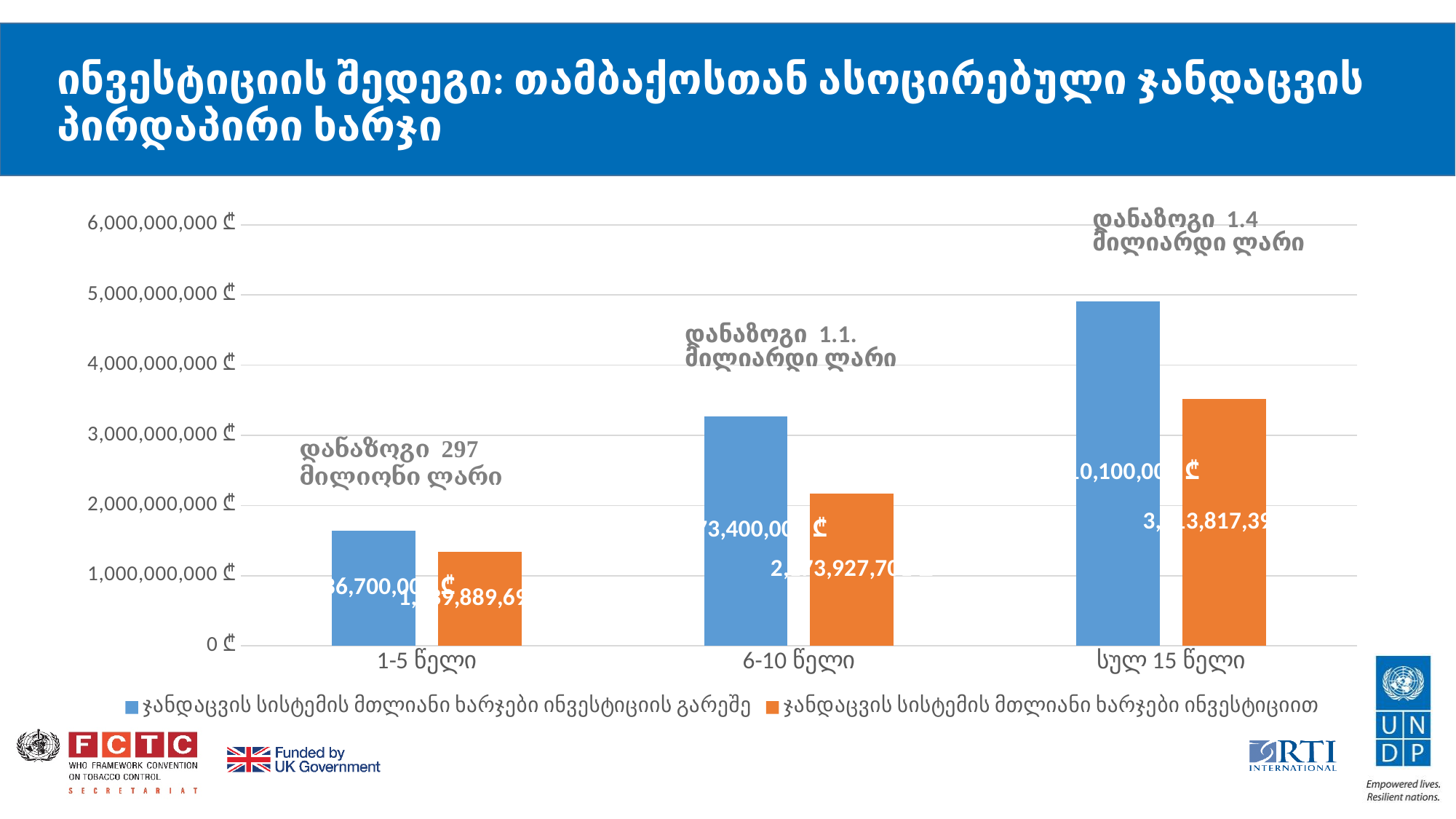
Is the value of ჯანდაცვის სისტემის მთლიანი ხარჯები ინვესტიციის გარეშე for სულ 15 წელი greater or less than 5,000,000,000 ₾? less Which category has the tallest bar in the chart? სულ 15 წელი How many series does the chart legend list? 2 What colour are the bars for ჯანდაცვის სისტემის მთლიანი ხარჯები ინვესტიციით? orange How many categories are shown on the x axis of the chart? 3 Do the values of ჯანდაცვის სისტემის მთლიანი ხარჯები ინვესტიციით rise or fall from 1-5 წელი to სულ 15 წელი? rise For 6-10 წელი, which series has the larger value: ჯანდაცვის სისტემის მთლიანი ხარჯები ინვესტიციის გარეშე or ჯანდაცვის სისტემის მთლიანი ხარჯები ინვესტიციით? ჯანდაცვის სისტემის მთლიანი ხარჯები ინვესტიციის გარეშე What savings (დანაზოგი) does the chart annotation state for 6-10 წელი? 1.1 მილიარდი ლარი What kind of chart is shown on the slide? bar chart Which bar is the lowest in the chart? ჯანდაცვის სისტემის მთლიანი ხარჯები ინვესტიციით for 1-5 წელი Is the value of ჯანდაცვის სისტემის მთლიანი ხარჯები ინვესტიციით for 6-10 წელი greater or less than 2,000,000,000 ₾? greater Is the value of ჯანდაცვის სისტემის მთლიანი ხარჯები ინვესტიციის გარეშე for 1-5 წელი greater or less than 2,000,000,000 ₾? less